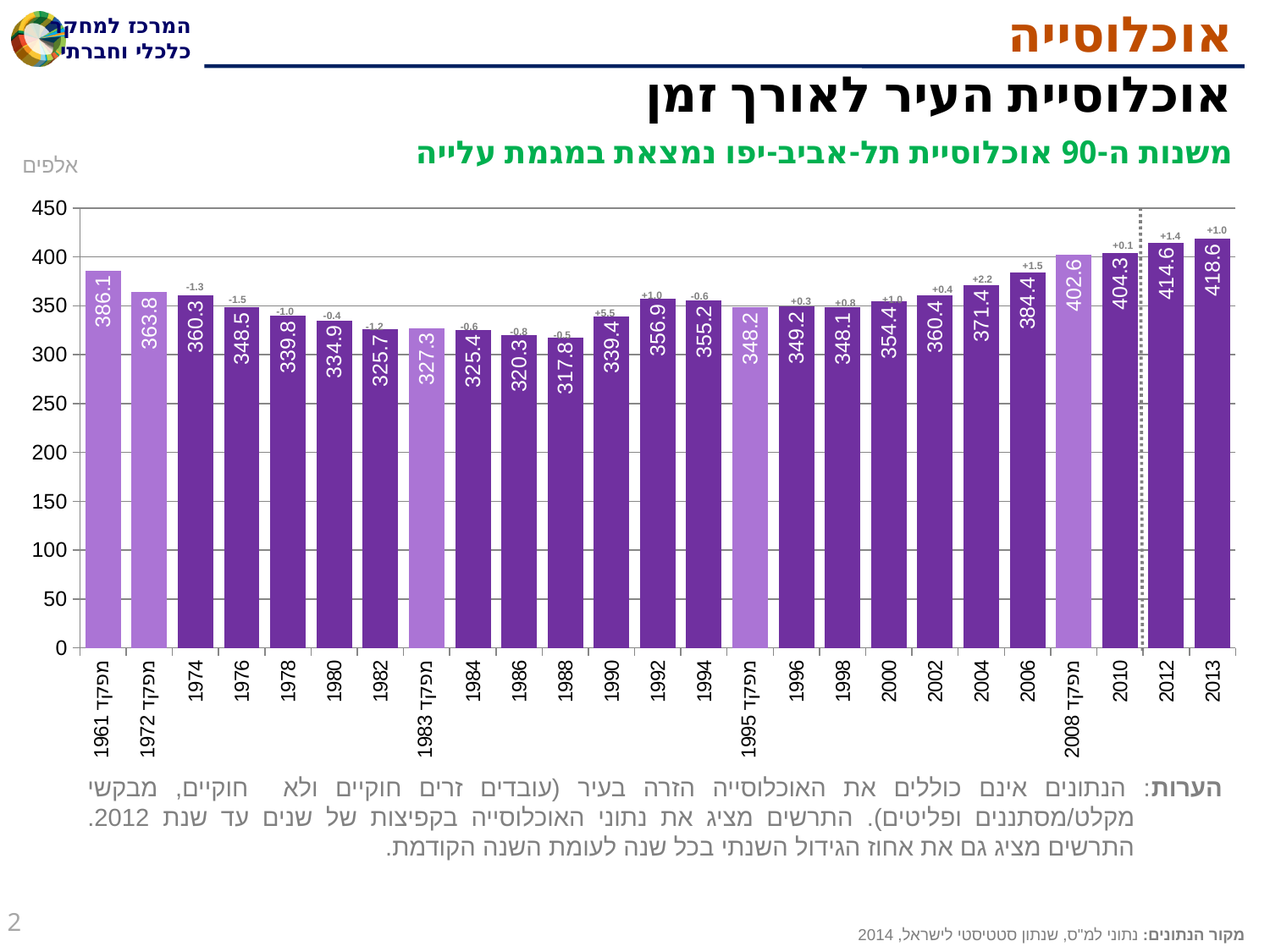
What is the value shown for the 1961 census bar (מפקד 1961)? 386.1 What is the population value shown for 2013? 418.6 What is the difference between the values for 2013 and 2012? 4.0 Which year has the lowest population value on the chart? 1988 What type of chart is shown on the slide? Bar chart What is the value shown for the 2008 census bar (מפקד 2008)? 402.6 What is the difference between the values for the 1961 census and 1988? 68.3 Do the values rise or fall from 1988 to 2013? Rise How many bars are plotted on the chart? 25 Which year has the highest population value on the chart? 2013 What is the value shown for 1988? 317.8 Which is larger, the value for 1992 or the value for 1994? 1992